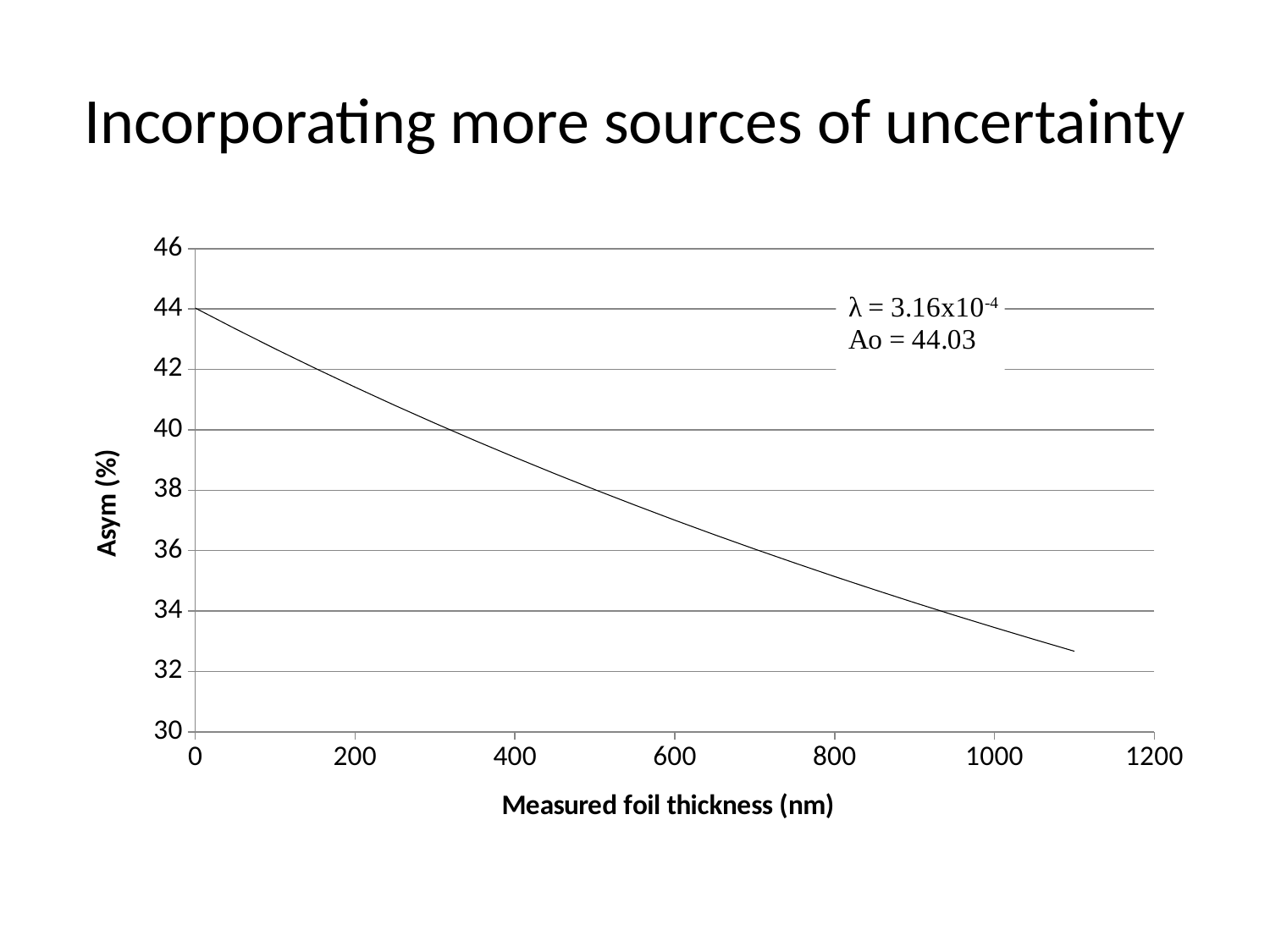
Is the value of Asym (%) at a measured foil thickness of 400 nm greater or less than 38? greater Is the value of Asym (%) at a measured foil thickness of 1000 nm greater or less than 36? less Is the value of Asym (%) at the right end of the curve (about 1100 nm) greater or less than 34? less Does Asym (%) rise or fall as measured foil thickness increases? fall What is the label of the x axis of the chart? Measured foil thickness (nm) What value of Ao is printed on the chart? 44.03 What kind of chart is shown on the slide? line chart